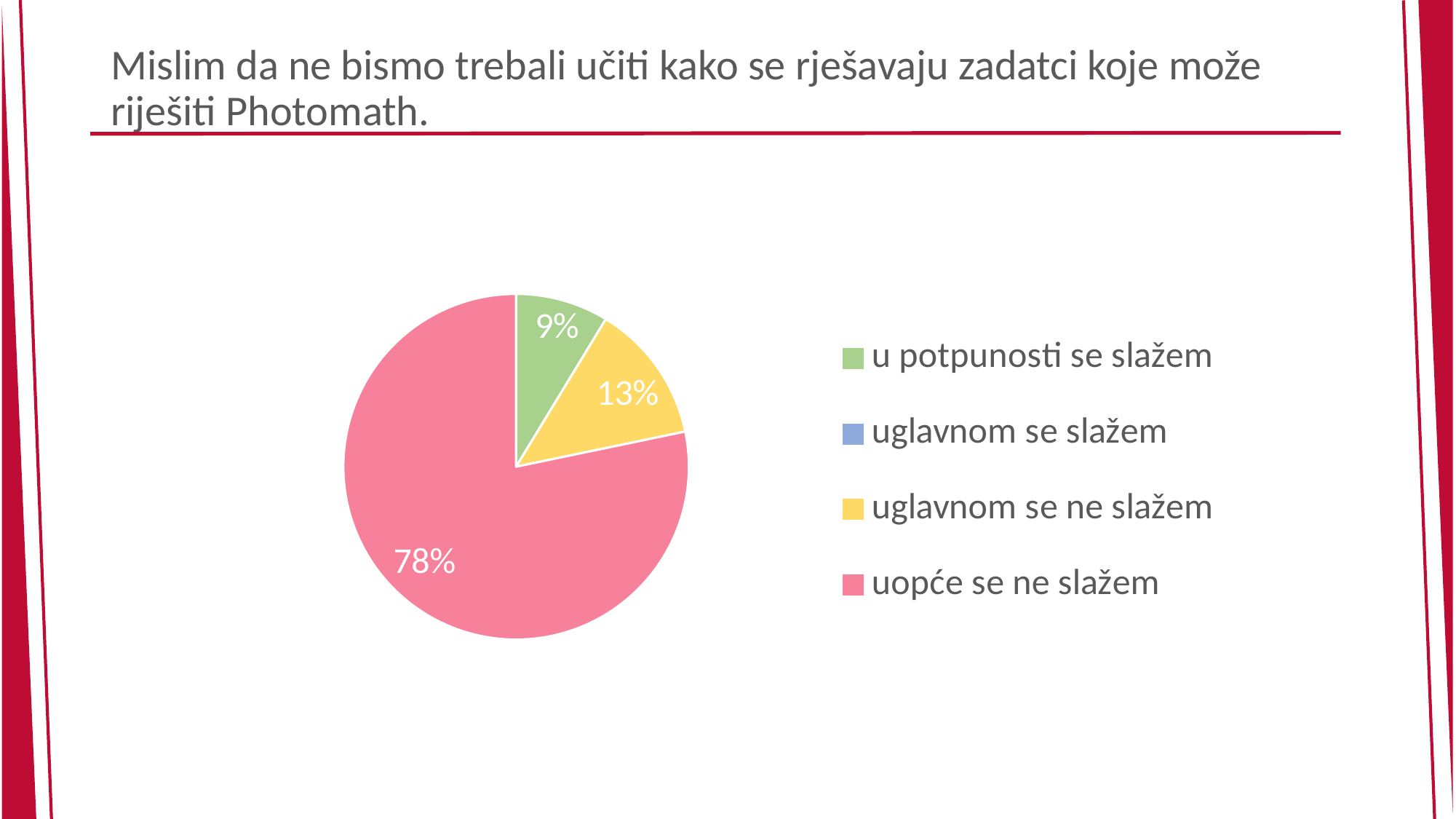
What colour is the slice for "uopće se ne slažem"? pink What percentage of the pie is labelled for "uopće se ne slažem"? 78% Which legend entry is shown with a green marker? u potpunosti se slažem How many categories does the legend list? 4 Which is larger, the slice for "uglavnom se ne slažem" or the slice for "u potpunosti se slažem"? uglavnom se ne slažem Which of the labelled slices is the smallest? u potpunosti se slažem What is the difference in percentage points between "uopće se ne slažem" and "uglavnom se ne slažem"? 65 What percentage of the pie is labelled for "u potpunosti se slažem"? 9% What kind of chart is shown on the slide? pie chart Which category has the largest slice of the pie? uopće se ne slažem What is the difference in percentage points between "uglavnom se ne slažem" and "u potpunosti se slažem"? 4 What percentage of the pie is labelled for "uglavnom se ne slažem"? 13%